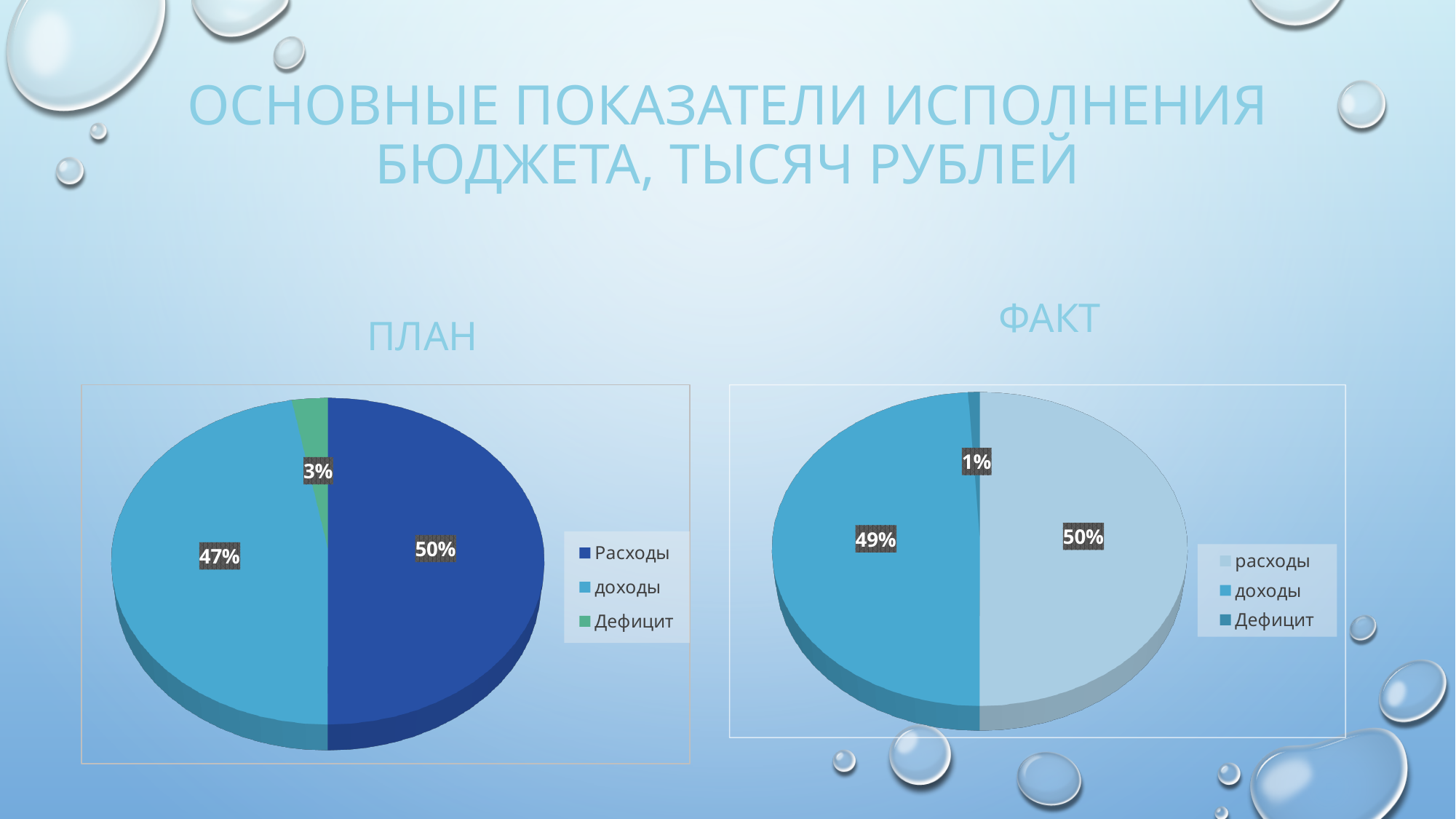
In the ФАКТ chart, which category has the smallest slice? Дефицит In the ФАКТ chart, what share does расходы have? 50% What type of chart is the ФАКТ chart? Pie chart In the ПЛАН chart, what share does Дефицит have? 3% In the ФАКТ chart, what share does доходы have? 49% In the ПЛАН chart, what share does Расходы have? 50% In the ПЛАН chart, which category has the smallest slice? Дефицит In the ПЛАН chart, which is larger, Расходы or доходы? Расходы In the ФАКТ chart, what share does Дефицит have? 1% How many categories does the legend of the ПЛАН chart list? 3 In the ПЛАН chart, what share does доходы have? 47% In the ПЛАН chart, what is the difference between the Расходы and доходы shares? 3%